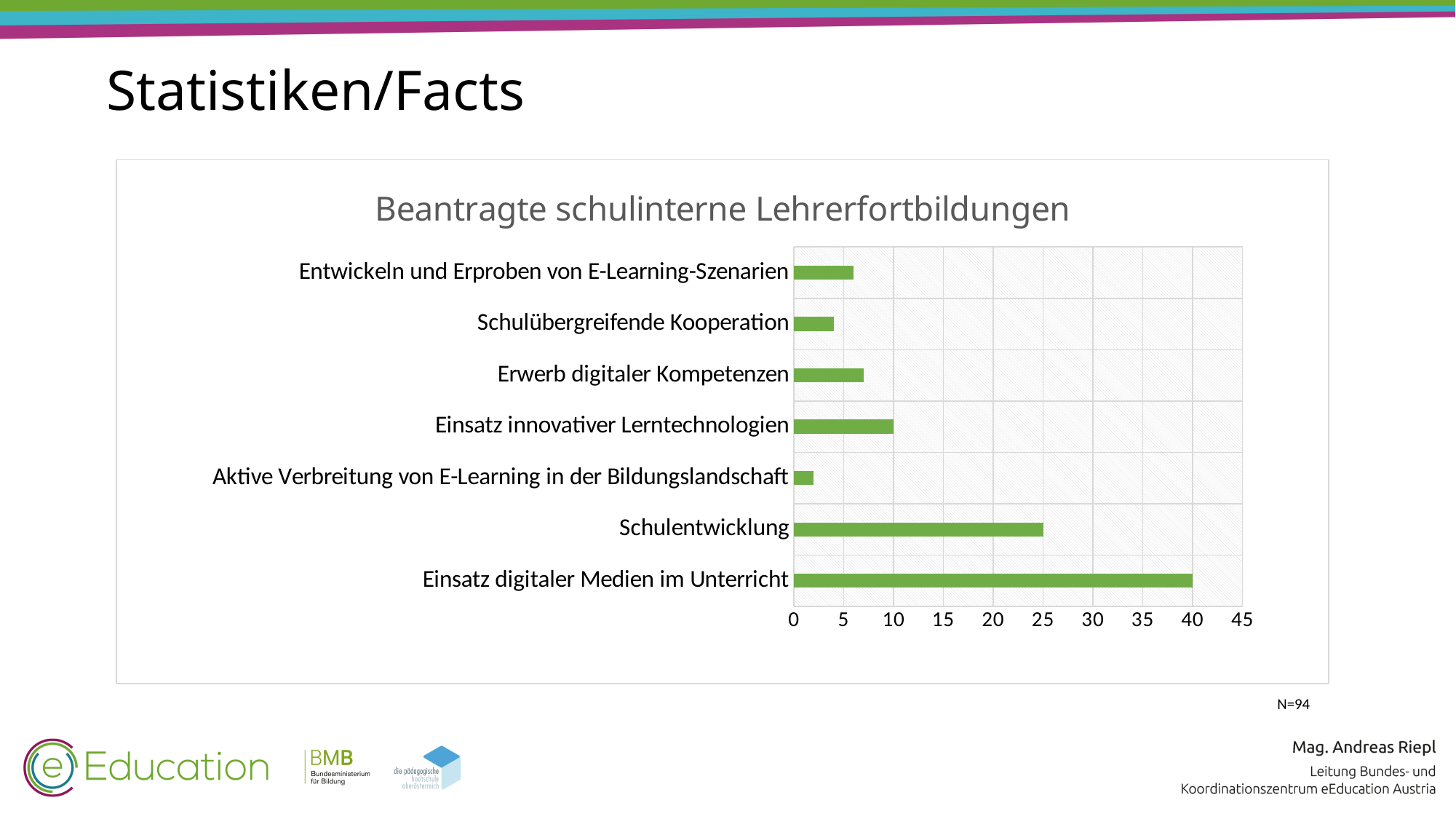
What is the difference between the values for Einsatz digitaler Medien im Unterricht and Schulentwicklung? 15 What is the value for Einsatz digitaler Medien im Unterricht? 40 How many categories are shown in the chart? 7 Which category has the highest value? Einsatz digitaler Medien im Unterricht What is the title of the chart? Beantragte schulinterne Lehrerfortbildungen Which category has the lowest value? Aktive Verbreitung von E-Learning in der Bildungslandschaft Is the value for Erwerb digitaler Kompetenzen greater or less than 5? greater Which is larger, the value for Schulentwicklung or the value for Einsatz innovativer Lerntechnologien? Schulentwicklung What type of chart is shown on the slide? bar chart Is the value for Schulübergreifende Kooperation greater or less than 5? less What is the value for Schulentwicklung? 25 What is the value for Einsatz innovativer Lerntechnologien? 10